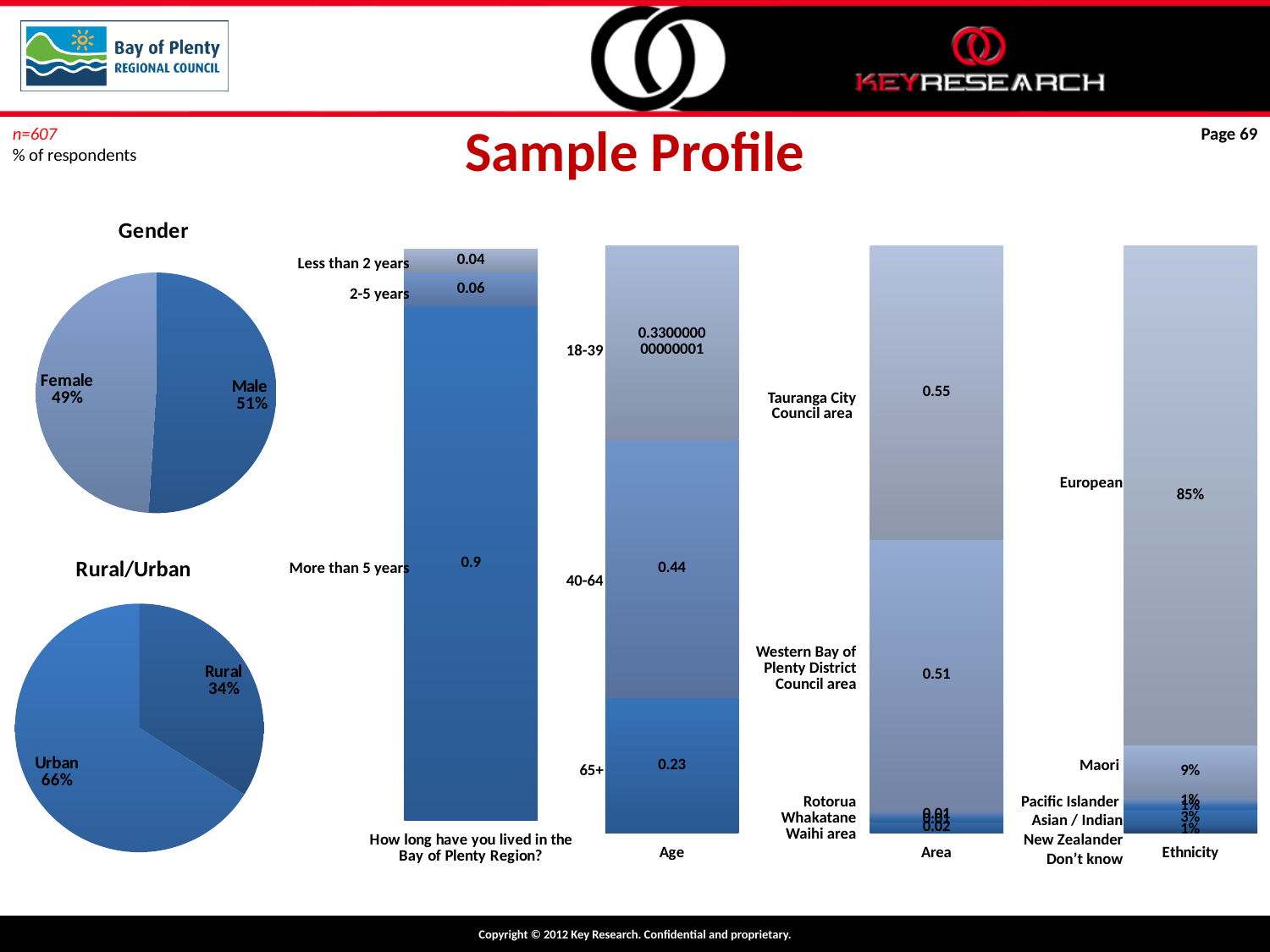
In the Gender pie chart, which slice is larger, Male or Female? Male In the 'How long have you lived in the Bay of Plenty Region?' bar chart, what is the value for More than 5 years? 0.9 In the Ethnicity bar chart, what percentage of respondents are European? 85% In the Rural/Urban pie chart, what percentage of respondents are Urban? 66% What kind of chart is the Gender chart? Pie chart In the 'How long have you lived in the Bay of Plenty Region?' bar chart, which category has the lowest value? Less than 2 years In the Age bar chart, what is the value for the 40-64 group? 0.44 In the Area bar chart, what is the value for Tauranga City Council area? 0.55 In the Age bar chart, which age group has the largest value? 40-64 In the Rural/Urban pie chart, what is the difference between the Urban and Rural shares? 32 percentage points How many categories are shown in the 'How long have you lived in the Bay of Plenty Region?' bar chart? 3 In the Gender pie chart, what percentage of respondents are Male? 51%